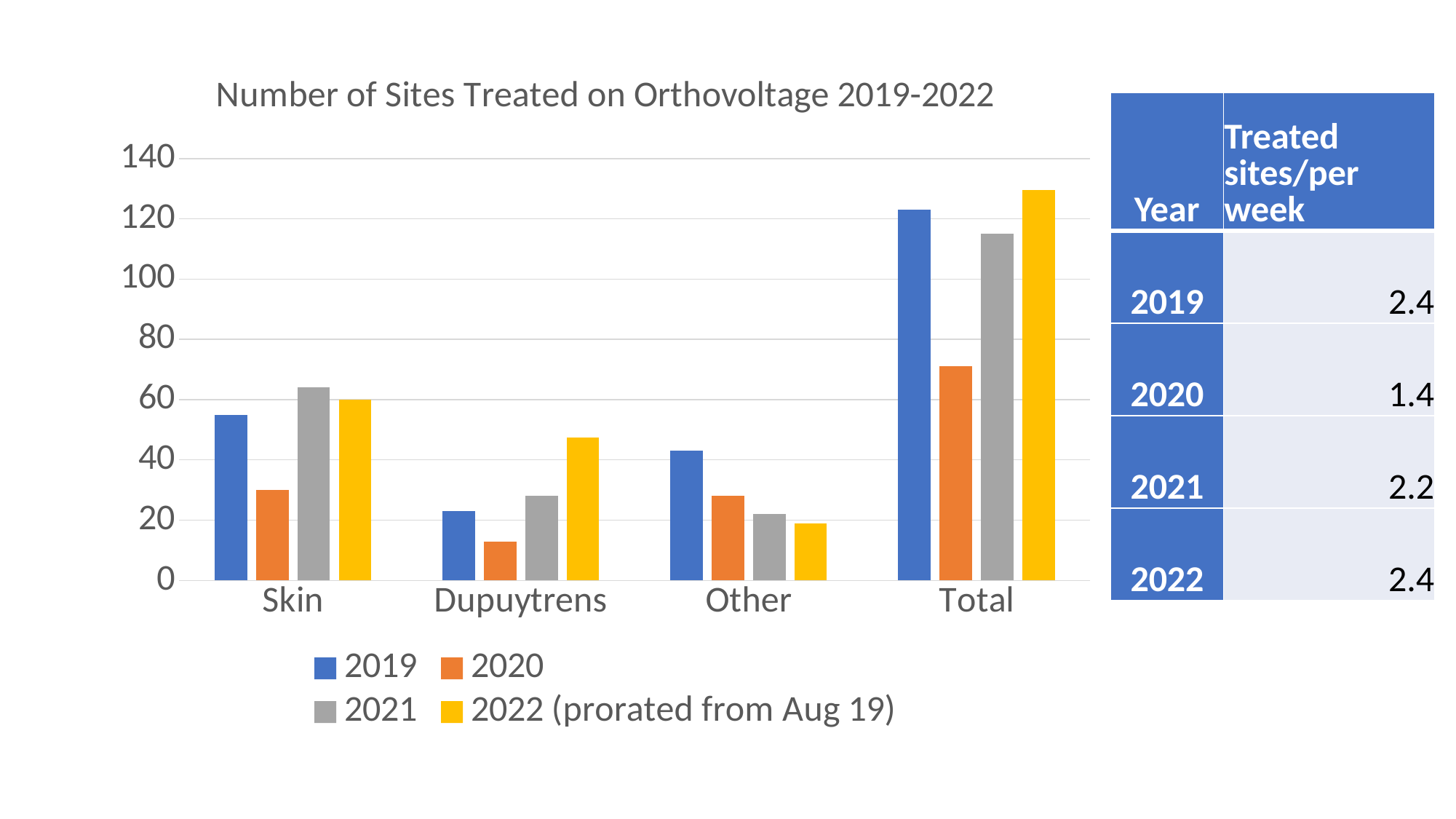
How many categories are shown on the x axis of the chart? 4 Is the value for Skin in 2020 greater or less than 40? less In the Dupuytrens category, which year has the lowest bar? 2020 Is the value for Dupuytrens in 2022 greater or less than 40? greater For the Skin category, which is larger: the 2019 bar or the 2021 bar? 2021 How many series does the chart legend list? 4 What is the title of the chart? Number of Sites Treated on Orthovoltage 2019-2022 In the Total category, which year has the lowest bar? 2020 In the Total category, which year has the highest bar? 2022 (prorated from Aug 19) Is the value for Total in 2020 greater or less than 80? less What kind of chart is shown on the slide? bar chart